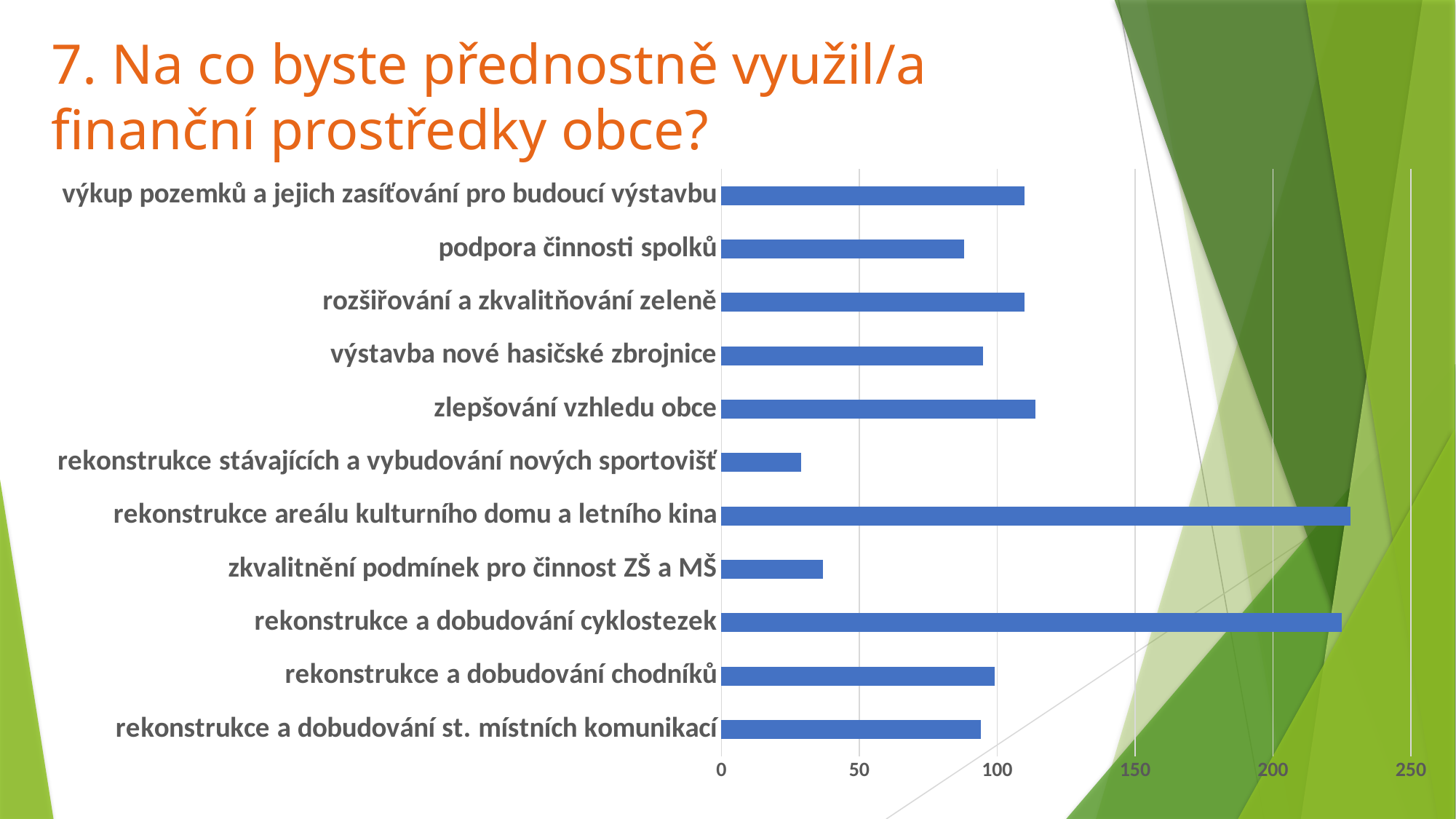
Is the value for 'zkvalitnění podmínek pro činnost ZŠ a MŠ' greater or less than 50? less How many categories are shown in the chart? 11 Is the value for 'rekonstrukce stávajících a vybudování nových sportovišť' greater or less than 50? less What is the highest value shown on the chart's horizontal axis? 250 Is the value for 'podpora činnosti spolků' greater or less than 100? less What is the title of the slide containing the chart? 7. Na co byste přednostně využil/a finanční prostředky obce? Which has a larger value: 'zlepšování vzhledu obce' or 'podpora činnosti spolků'? zlepšování vzhledu obce What kind of chart is shown on the slide? bar chart Which has a larger value: 'rekonstrukce areálu kulturního domu a letního kina' or 'rekonstrukce stávajících a vybudování nových sportovišť'? rekonstrukce areálu kulturního domu a letního kina